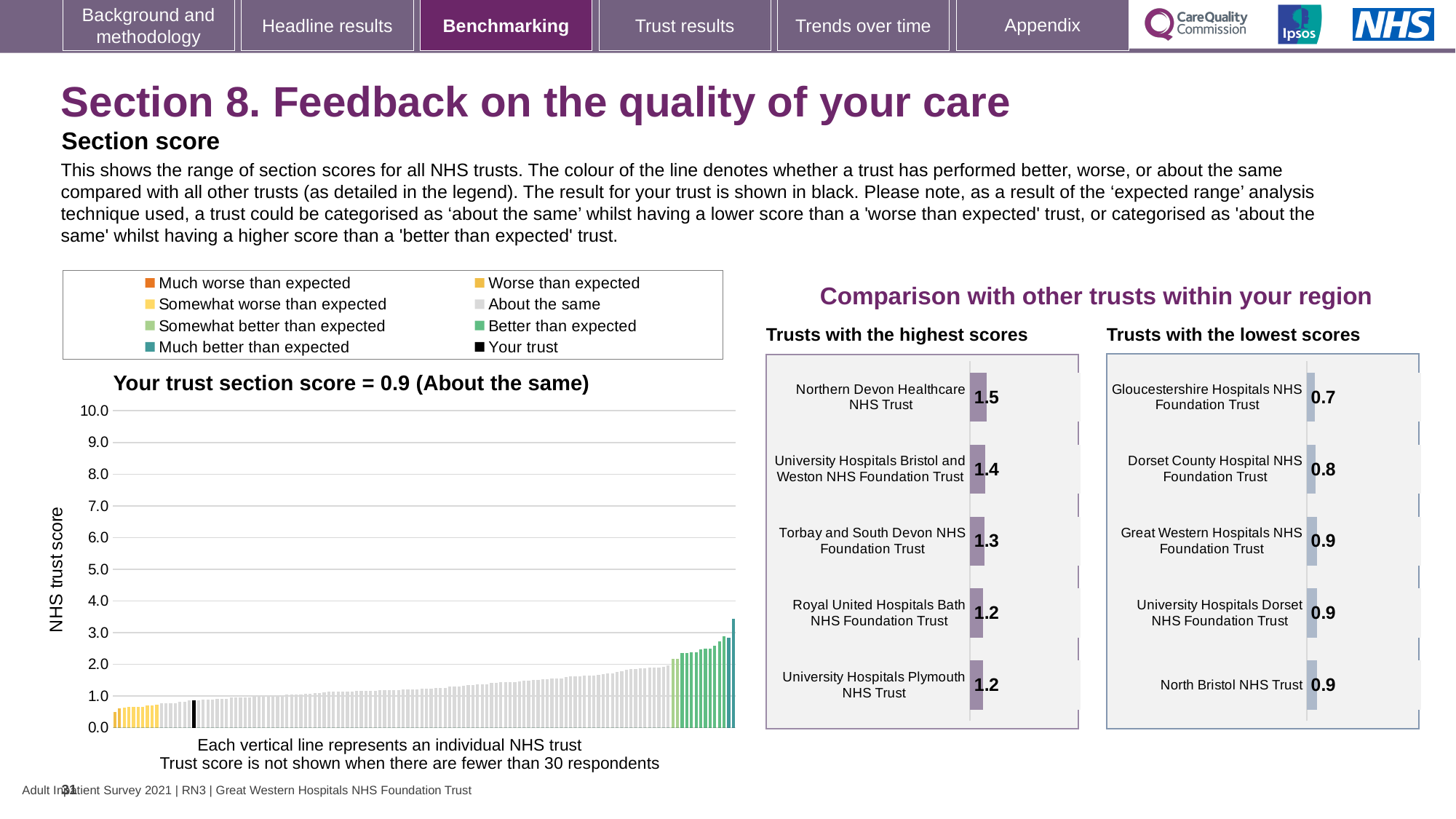
In the 'Trusts with the lowest scores' chart, which trust has the lowest score? Gloucestershire Hospitals NHS Foundation Trust In the 'Trusts with the lowest scores' chart, what is the score for Gloucestershire Hospitals NHS Foundation Trust? 0.7 What kind of chart is the 'Your trust section score' chart on the left? Bar chart In the 'Trusts with the highest scores' chart, what is the score for Northern Devon Healthcare NHS Trust? 1.5 In the 'Trusts with the lowest scores' chart, what is the score for Dorset County Hospital NHS Foundation Trust? 0.8 In the 'Trusts with the highest scores' chart, which trust has the highest score? Northern Devon Healthcare NHS Trust According to the title of the chart on the left, what is your trust's section score? 0.9 (About the same) In the 'Trusts with the lowest scores' chart, what is the difference between the scores of North Bristol NHS Trust and Gloucestershire Hospitals NHS Foundation Trust? 0.2 How many trusts are shown in the 'Trusts with the lowest scores' chart? 5 In the 'Trusts with the highest scores' chart, what is the score for Torbay and South Devon NHS Foundation Trust? 1.3 In the 'Trusts with the highest scores' chart, what is the difference between the scores of Northern Devon Healthcare NHS Trust and University Hospitals Plymouth NHS Trust? 0.3 In the 'Trusts with the highest scores' chart, which has the larger score: University Hospitals Bristol and Weston NHS Foundation Trust or Royal United Hospitals Bath NHS Foundation Trust? University Hospitals Bristol and Weston NHS Foundation Trust